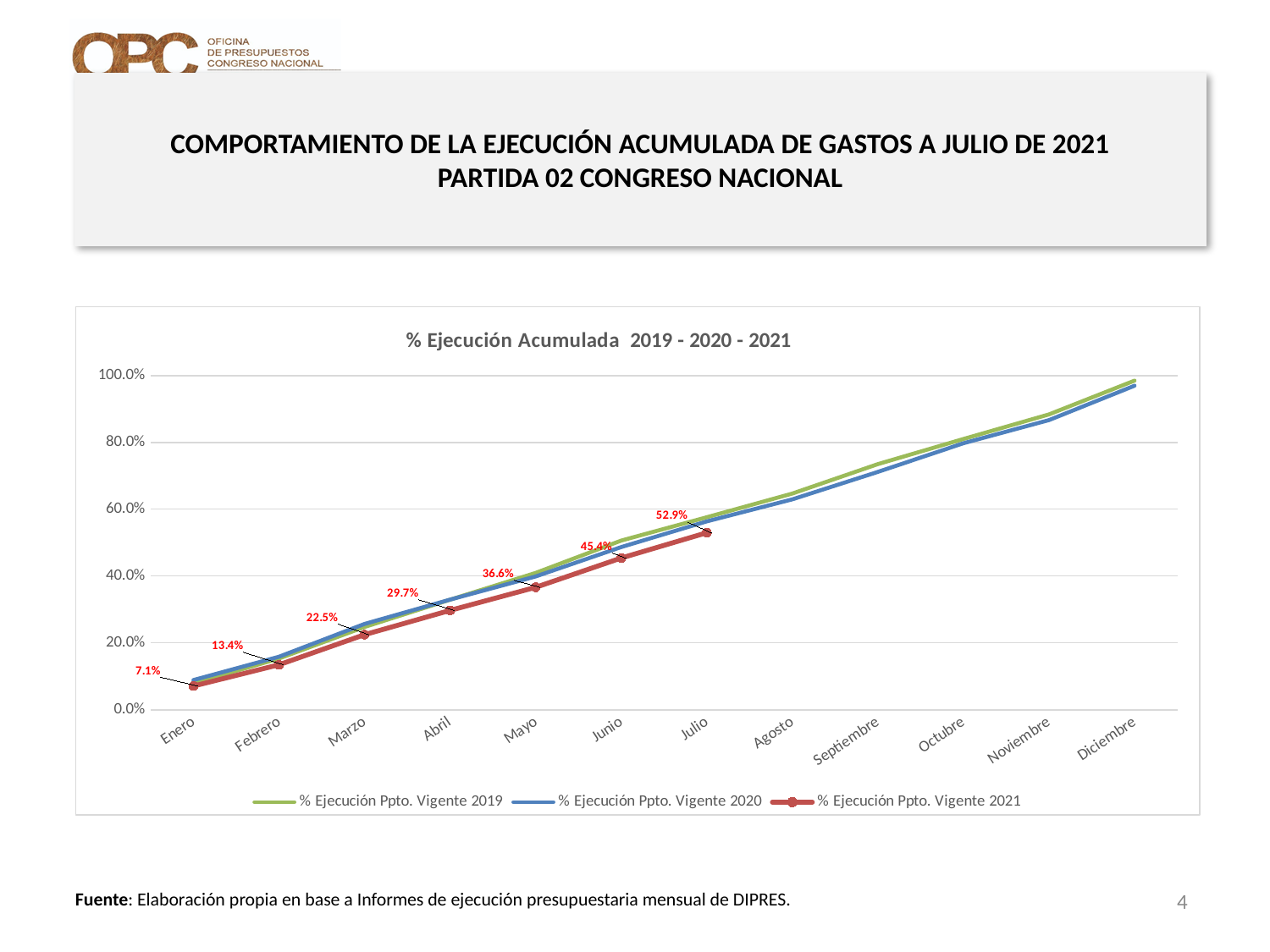
What is the value for Julio in the % Ejecución Ppto. Vigente 2021 series? 52.9% Do the values of the % Ejecución Ppto. Vigente 2019 series rise or fall from Enero to Diciembre? Rise What kind of chart is shown on the slide? Line chart How many months are shown on the x axis? 12 What is the value for Mayo in the % Ejecución Ppto. Vigente 2021 series? 36.6% What is the difference between the Julio and Enero values in the % Ejecución Ppto. Vigente 2021 series? 45.8% What is the value for Enero in the % Ejecución Ppto. Vigente 2021 series? 7.1% What is the difference between the Marzo and Febrero values in the % Ejecución Ppto. Vigente 2021 series? 9.1% What is the value for Abril in the % Ejecución Ppto. Vigente 2021 series? 29.7% Is the value for Noviembre in the % Ejecución Ppto. Vigente 2020 series greater or less than 80.0%? greater Which month has the highest value in the % Ejecución Ppto. Vigente 2021 series? Julio How many series does the legend list? 3